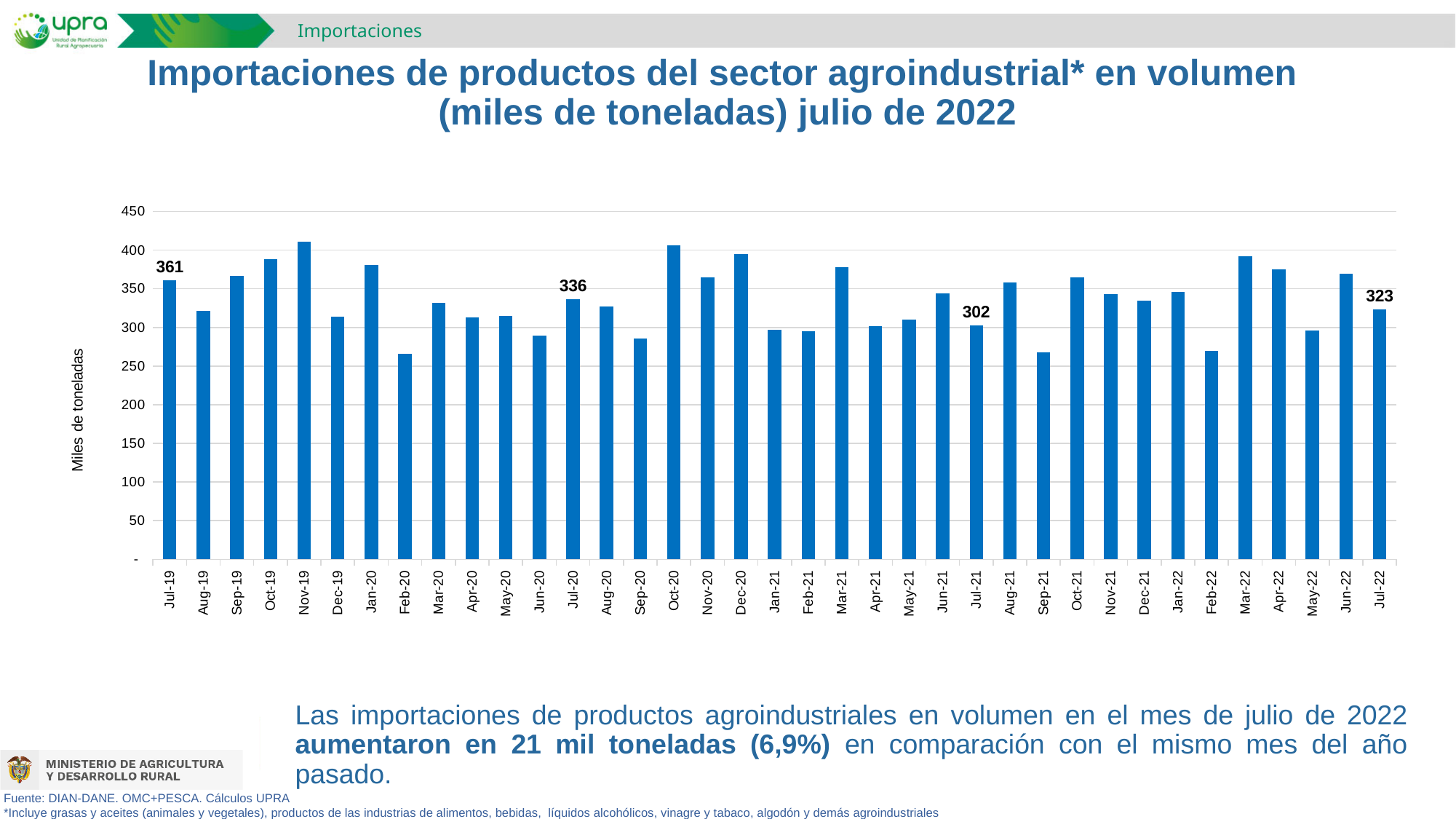
Is the value for Feb-20 greater or less than 300? less What is the value for Jul-20? 336 What is the value for Jul-21? 302 What kind of chart is shown on the slide? bar chart How many months (bars) are plotted on the chart? 37 Which is larger, the value for Jul-19 or the value for Jul-22? Jul-19 What is the value for Jul-19? 361 What is the label of the vertical axis? Miles de toneladas What is the difference between the values for Jul-19 and Jul-20? 25 What is the value for Jul-22? 323 What is the difference between the values for Jul-22 and Jul-21? 21 Is the value for Nov-19 greater or less than 400? greater